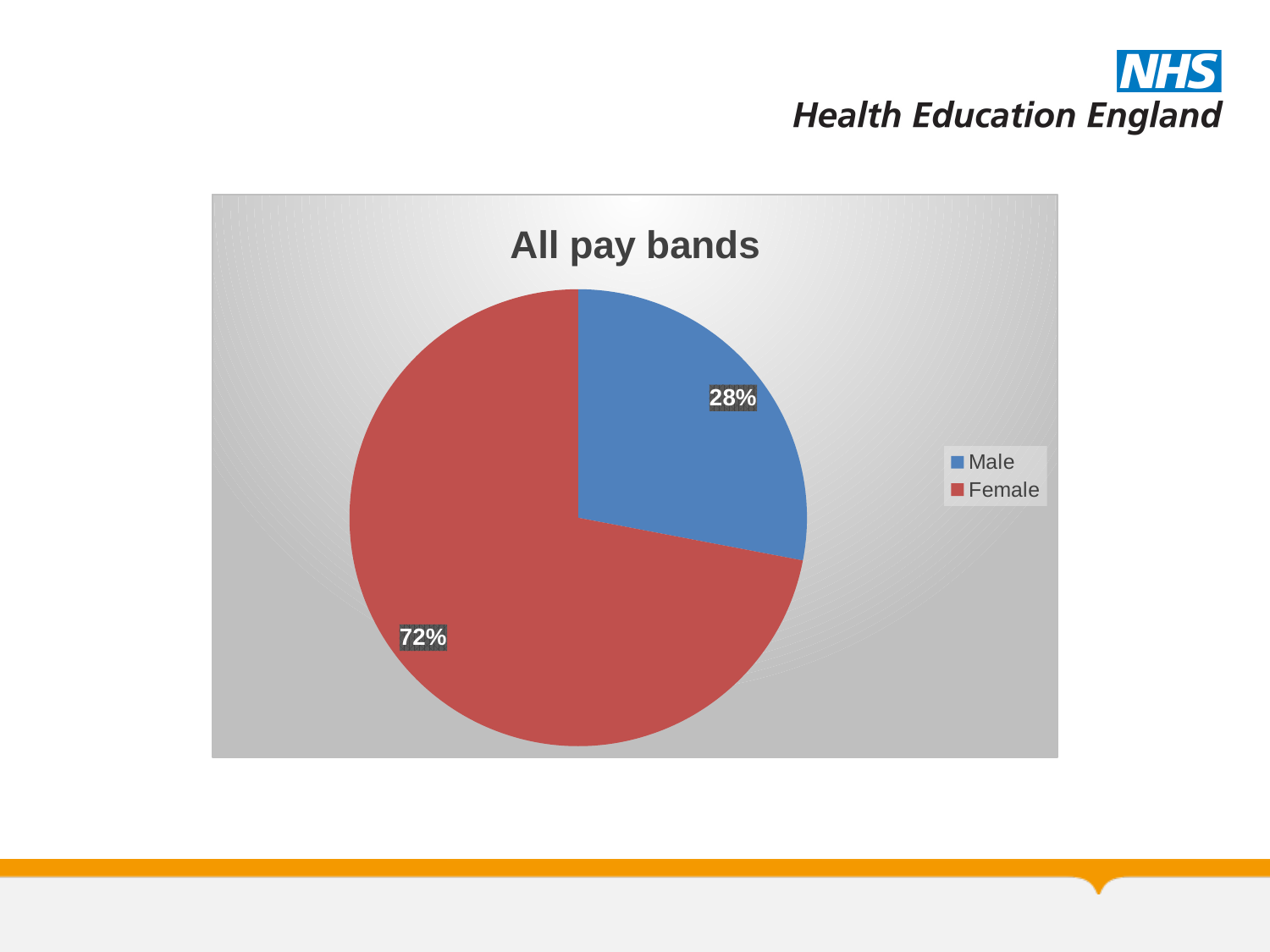
Which category has the largest slice of the pie? Female Which category has the smallest slice of the pie? Male How many entries does the legend list? 2 What is the difference in percentage points between the Female and Male shares? 44 What is the title of the chart? All pay bands What share of the pie does Male represent? 28% What kind of chart is shown on the slide? Pie chart What share of the pie does Female represent? 72% How many slices does the pie chart have? 2 What colour is the Male slice? Blue Which is larger, the Male share or the Female share? Female